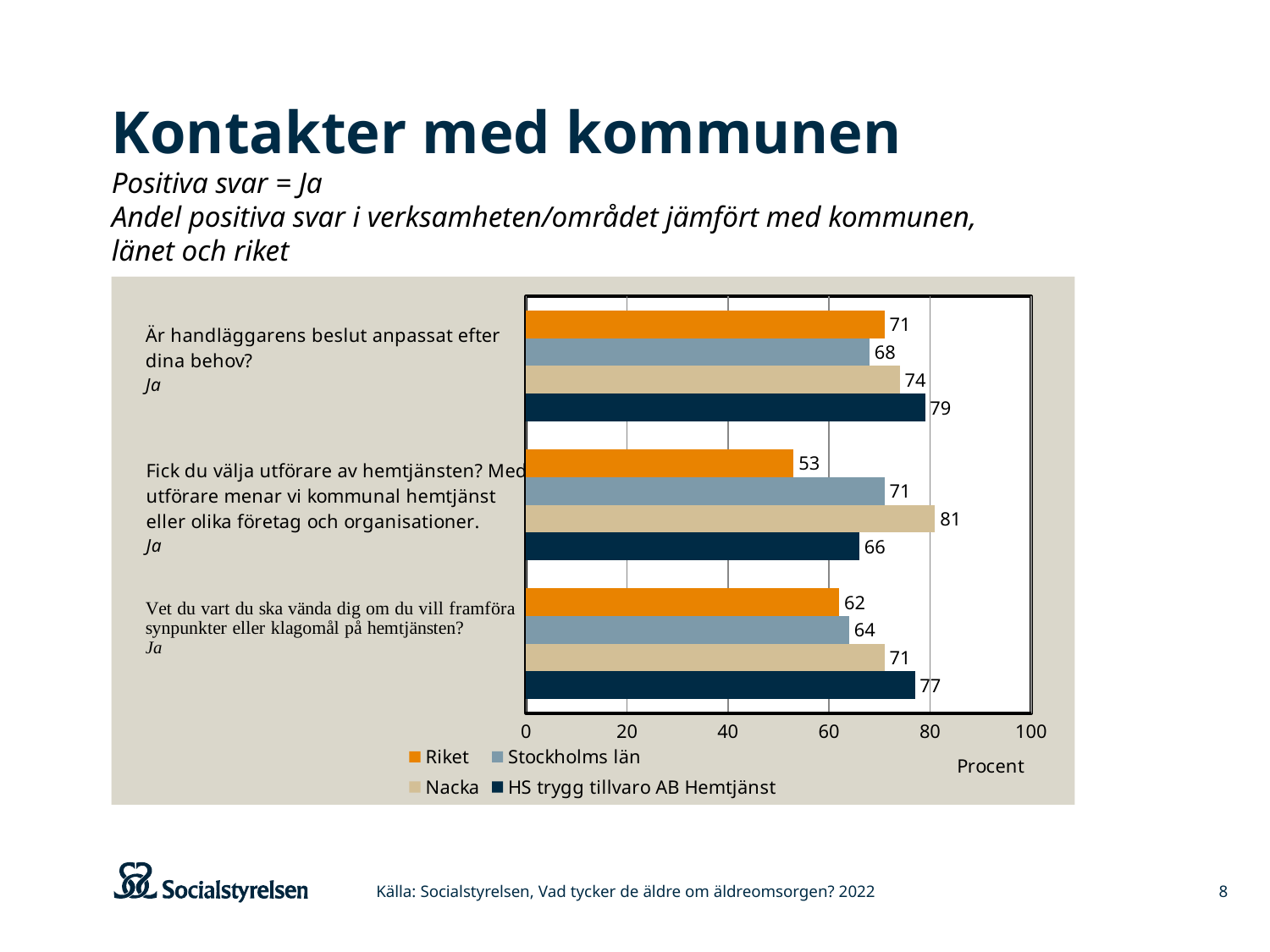
How many questions (categories) are shown on the chart? 3 What is the difference between the HS trygg tillvaro AB Hemtjänst value and the Riket value on the question "Vet du vart du ska vända dig om du vill framföra synpunkter eller klagomål på hemtjänsten?"? 15 Which series has the highest value on the question "Fick du välja utförare av hemtjänsten?"? Nacka How many series does the legend list? 4 On the question "Fick du välja utförare av hemtjänsten?", which is larger: the value for Stockholms län or the value for HS trygg tillvaro AB Hemtjänst? Stockholms län What is the value for Riket on the question "Fick du välja utförare av hemtjänsten?"? 53 What is the value for HS trygg tillvaro AB Hemtjänst on the question "Är handläggarens beslut anpassat efter dina behov?"? 79 Which series is shown in orange in the legend? Riket What is the value for Nacka on the question "Vet du vart du ska vända dig om du vill framföra synpunkter eller klagomål på hemtjänsten?"? 71 What kind of chart is shown on the slide? bar chart What is the label of the horizontal axis? Procent Which series has the lowest value on the question "Är handläggarens beslut anpassat efter dina behov?"? Stockholms län